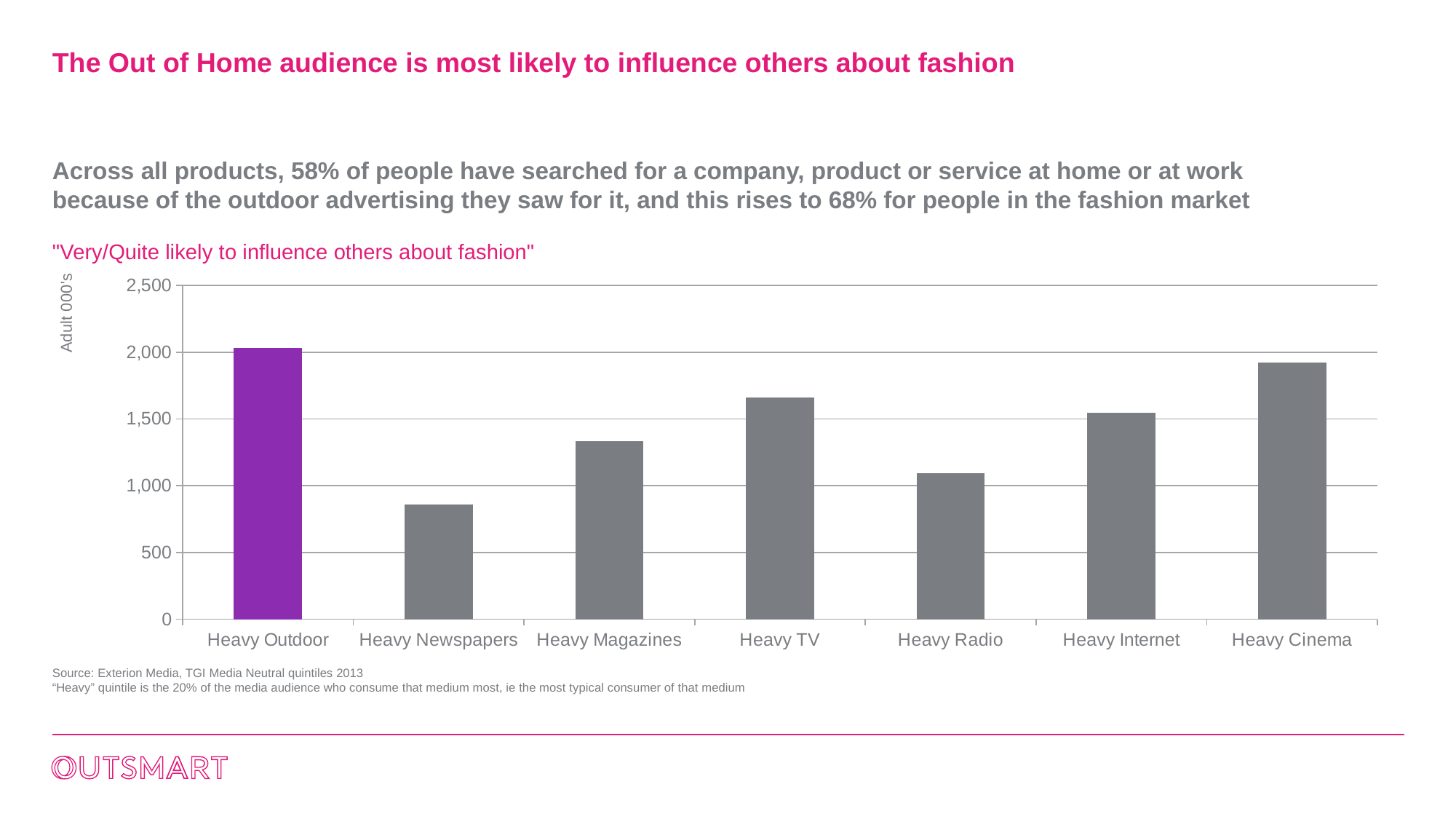
What kind of chart is shown on the slide? Bar chart How many categories are plotted on the chart? 7 Which is larger, the value for Heavy Cinema or the value for Heavy TV? Heavy Cinema Is the value for Heavy TV greater or less than 1,500? greater Which bar is coloured purple rather than grey? Heavy Outdoor Is the value for Heavy Cinema greater or less than 2,000? less Which category has the lowest value? Heavy Newspapers Is the value for Heavy Newspapers greater or less than 1,000? less Which is larger, the value for Heavy Magazines or the value for Heavy Radio? Heavy Magazines Which category has the highest value? Heavy Outdoor What is the label on the vertical axis of the chart? Adult 000's